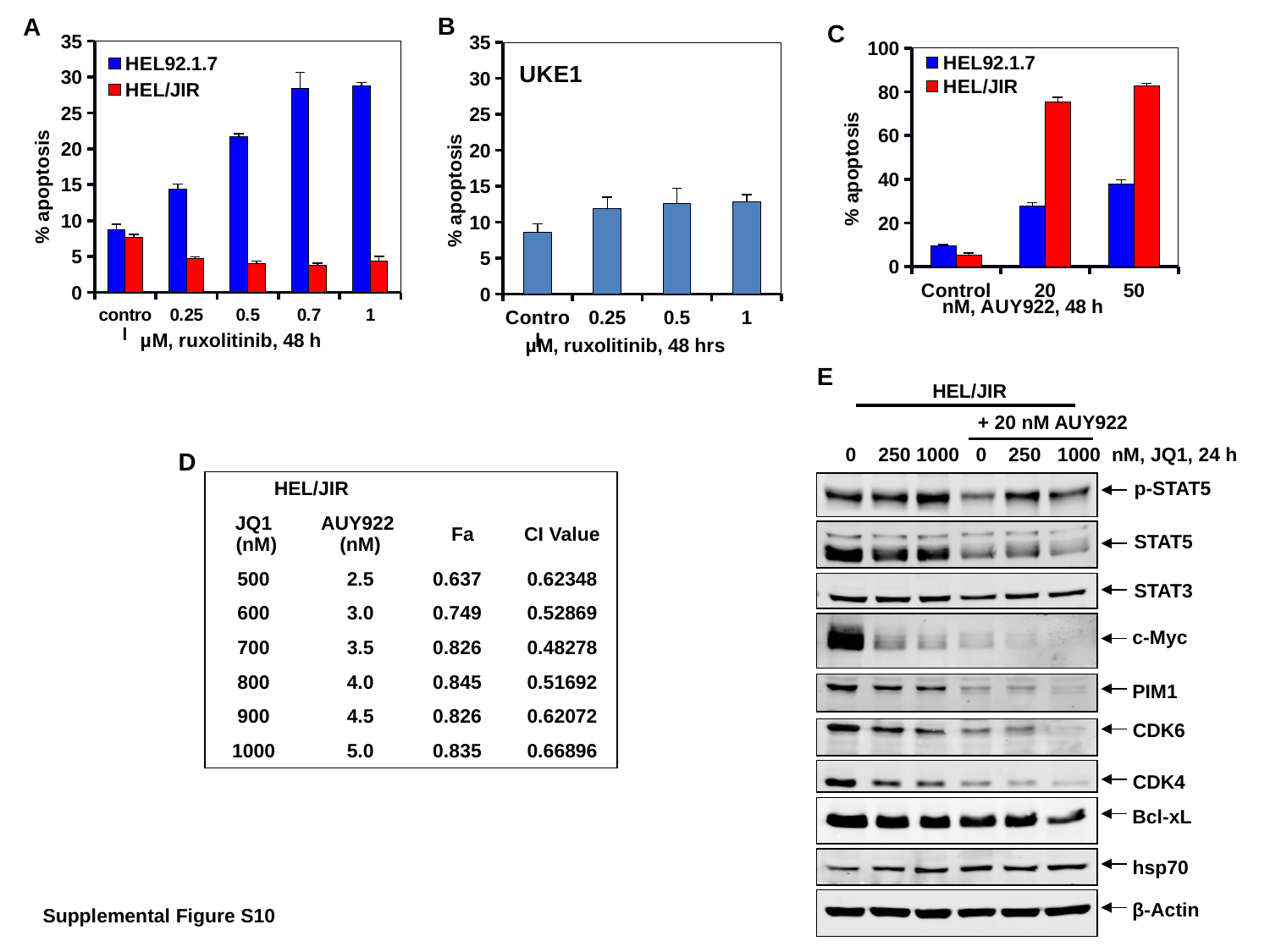
In chart A, at 0.7 µM ruxolitinib, which series has the larger value, HEL92.1.7 or HEL/JIR? HEL92.1.7 In chart C, at 20 nM AUY922, which series has the larger value, HEL92.1.7 or HEL/JIR? HEL/JIR In chart C, which category has the highest value for HEL/JIR? 50 In chart B (UKE1), how many categories are shown on the x axis? 4 In chart A, is the value for HEL92.1.7 at 0.5 µM ruxolitinib greater or less than 20? greater In chart C, is the value for HEL92.1.7 at 50 nM AUY922 greater or less than 40? less What kind of chart is chart C? bar chart In chart A, which category has the lowest value for HEL92.1.7? control In chart A, how many series does the legend list? 2 In chart B (UKE1), which category has the lowest value? Control In chart A, which category has the highest value for HEL/JIR? control In chart B (UKE1), is the value for 0.25 µM ruxolitinib greater or less than 10? greater